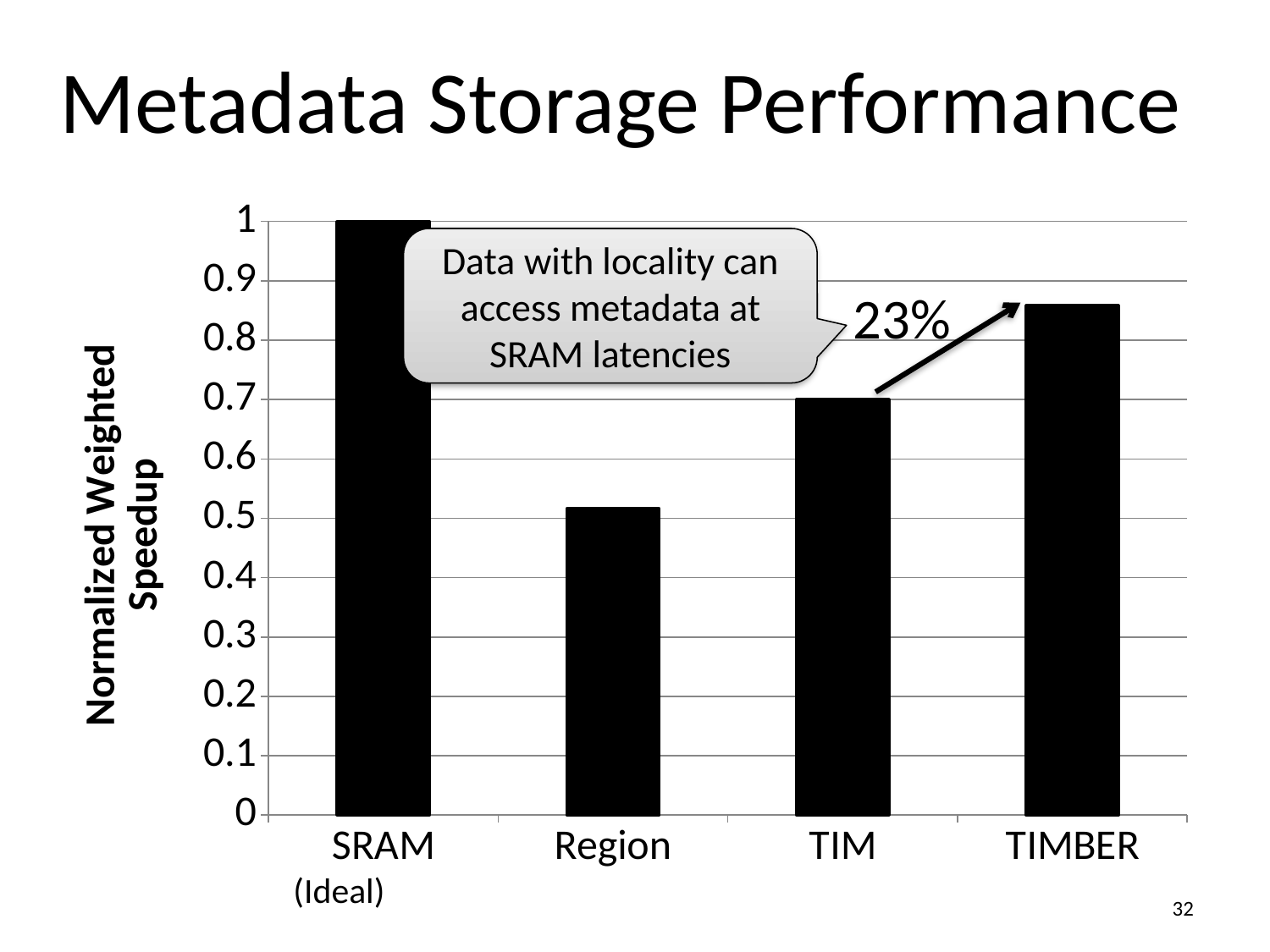
What kind of chart is shown on the slide? bar chart Is the value for TIMBER greater or less than 0.9? less Is the value for Region greater or less than 0.5? greater How many categories are plotted on the x axis of the chart? 4 Which has a higher normalized weighted speedup, Region or TIM? TIM Which category has the lowest normalized weighted speedup? Region What is the label on the y axis of the chart? Normalized Weighted Speedup Which has a higher normalized weighted speedup, TIM or TIMBER? TIMBER What is the normalized weighted speedup for SRAM (Ideal)? 1 Which category has the highest normalized weighted speedup? SRAM (Ideal) Is the value for TIM greater or less than 0.8? less